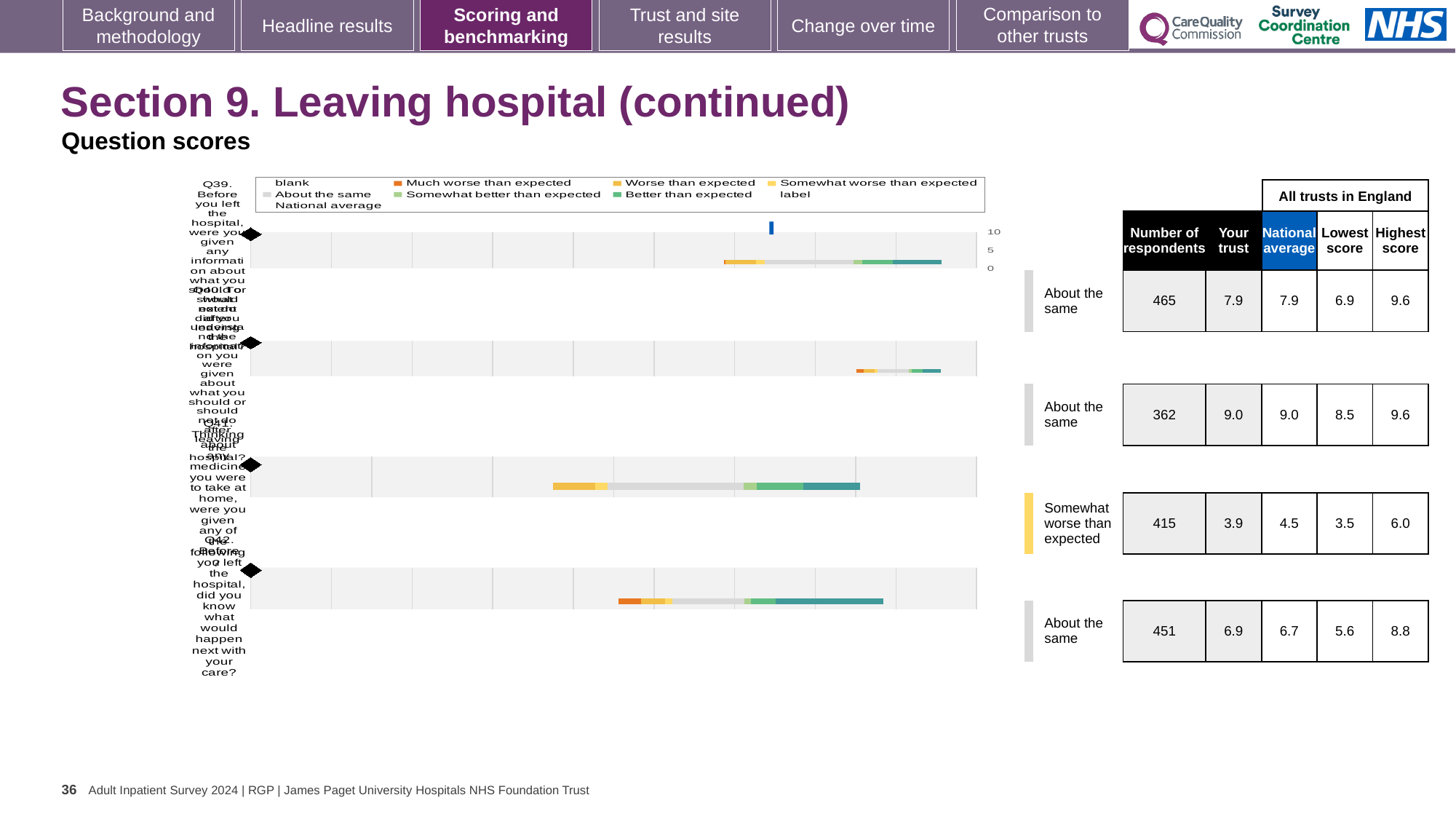
What is the national average score for Q41? 4.5 Which question has the lowest 'Your trust' score? Q41 How many questions (bars) are plotted in the chart? 4 What is the number of respondents for Q40? 362 Is the 'Your trust' score for Q41 larger or smaller than the national average for Q41? smaller What benchmark category is shown for Q41? Somewhat worse than expected Which question has the most respondents? Q39 What is the 'Your trust' score for Q39? 7.9 What kind of chart is shown on the slide? bar chart What is the difference between the 'Your trust' score and the national average for Q42? 0.2 Which question has the highest 'Your trust' score? Q40 What is the highest score across all trusts in England for Q42? 8.8